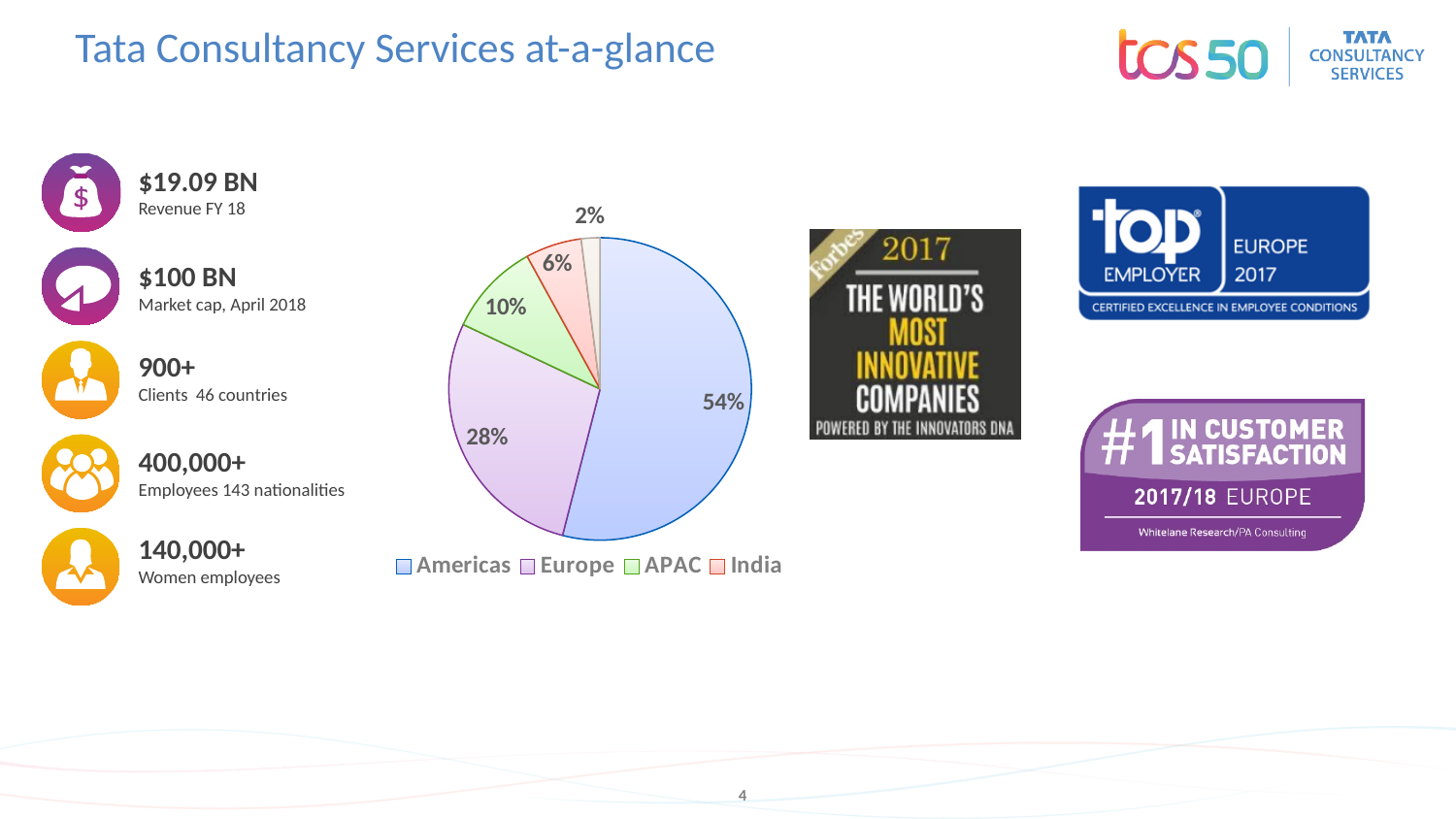
What colour is the Americas slice in the pie chart? blue Which slice is larger in the pie chart, Europe or APAC? Europe What kind of chart is shown on the slide? pie chart What percentage of the pie chart does India account for? 6% What percentage of the pie chart does Europe account for? 28% What percentage of the pie chart does Americas account for? 54% How many percentage points larger is the Americas slice than the Europe slice? 26 What is the smallest percentage label shown on the pie chart? 2% How many slices does the pie chart have? 5 What percentage of the pie chart does APAC account for? 10% How many entries does the pie chart legend list? 4 Which region has the largest slice in the pie chart? Americas